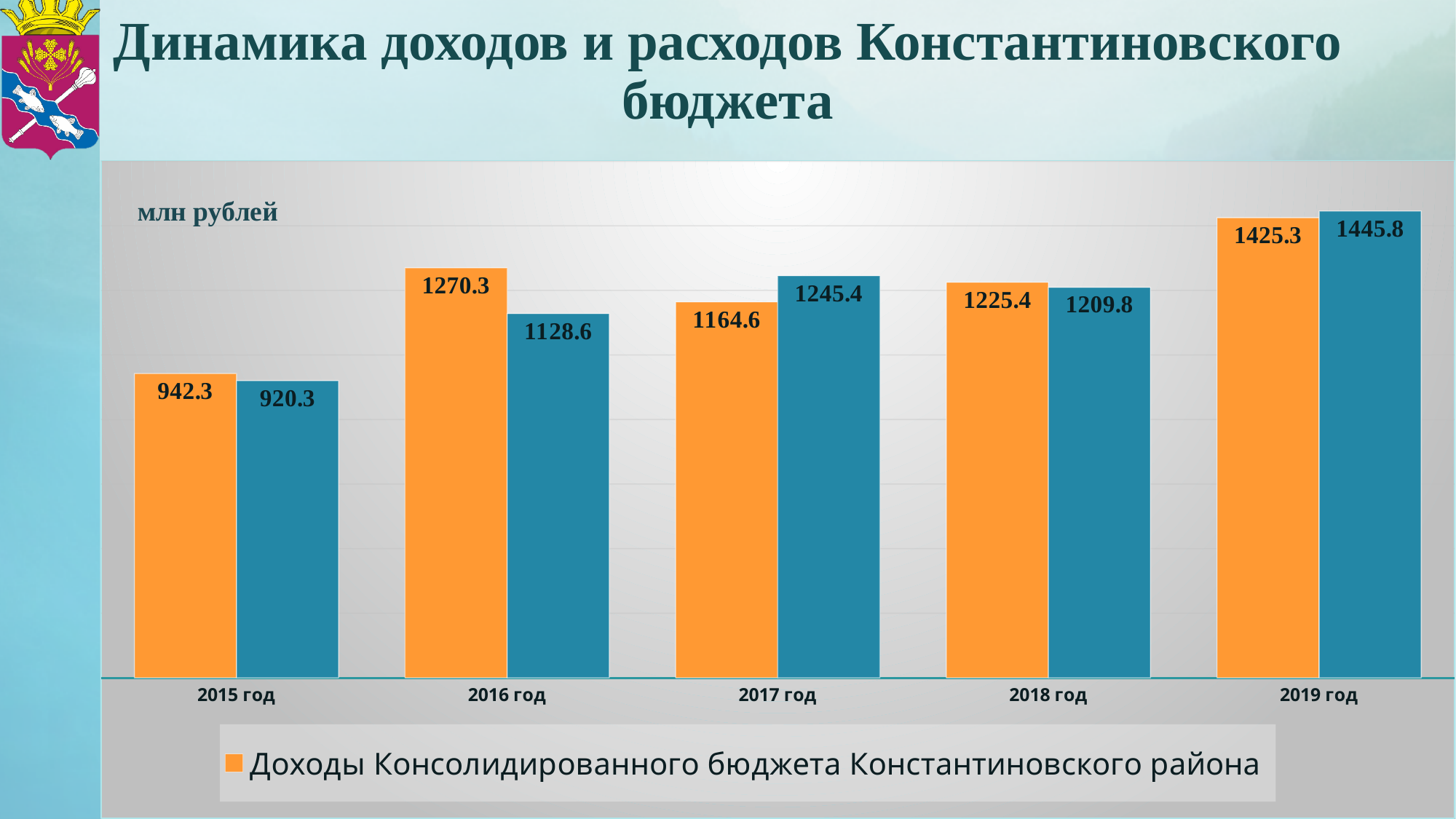
What unit is shown in the top-left corner of the chart? млн рублей Which is larger for 2018 год, the orange bar or the blue bar? the orange bar In which year is the blue bar lowest? 2015 год What is the value of Доходы Консолидированного бюджета Константиновского района for 2016 год? 1270.3 How many years are shown on the x axis? 5 Does the blue series rise or fall from 2018 год to 2019 год? rise What is the value of the blue bar for 2017 год? 1245.4 What is the value of the blue bar for 2019 год? 1445.8 What is the difference between the orange and blue bars for 2016 год? 141.7 What kind of chart is shown on the slide? bar chart In which year is Доходы Консолидированного бюджета Константиновского района highest? 2019 год What is the value of the orange bar for 2015 год? 942.3